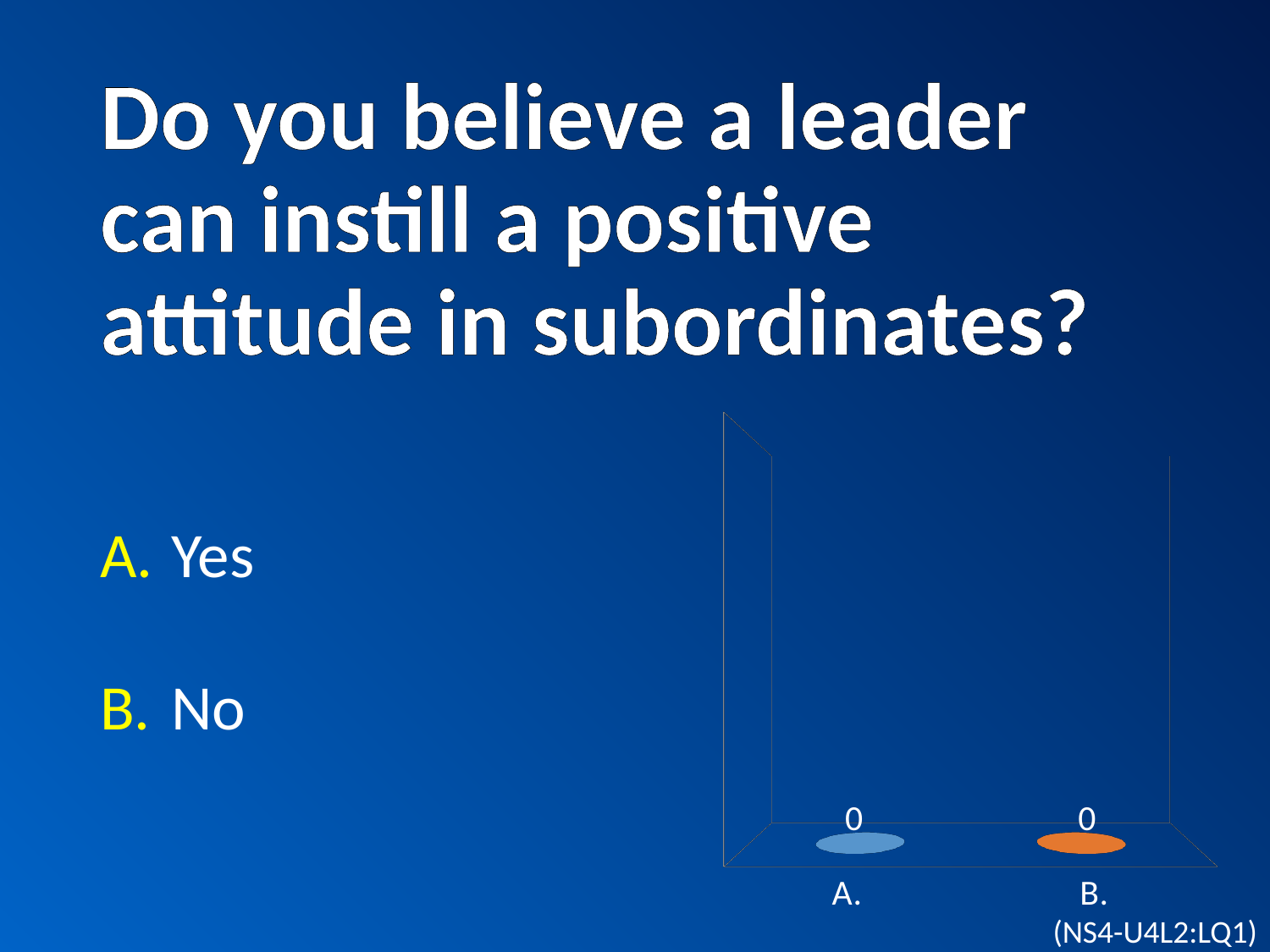
What colour is the bar for category B.? orange Is the value for A. larger than, smaller than, or equal to the value for B.? equal What is the value shown for category B. in the chart? 0 What kind of chart is shown on the slide? bar chart What are the category labels on the x axis of the chart? A. and B. What is the value shown for category A. in the chart? 0 How many categories are plotted in the chart? 2 What is the difference between the values for A. and B. in the chart? 0